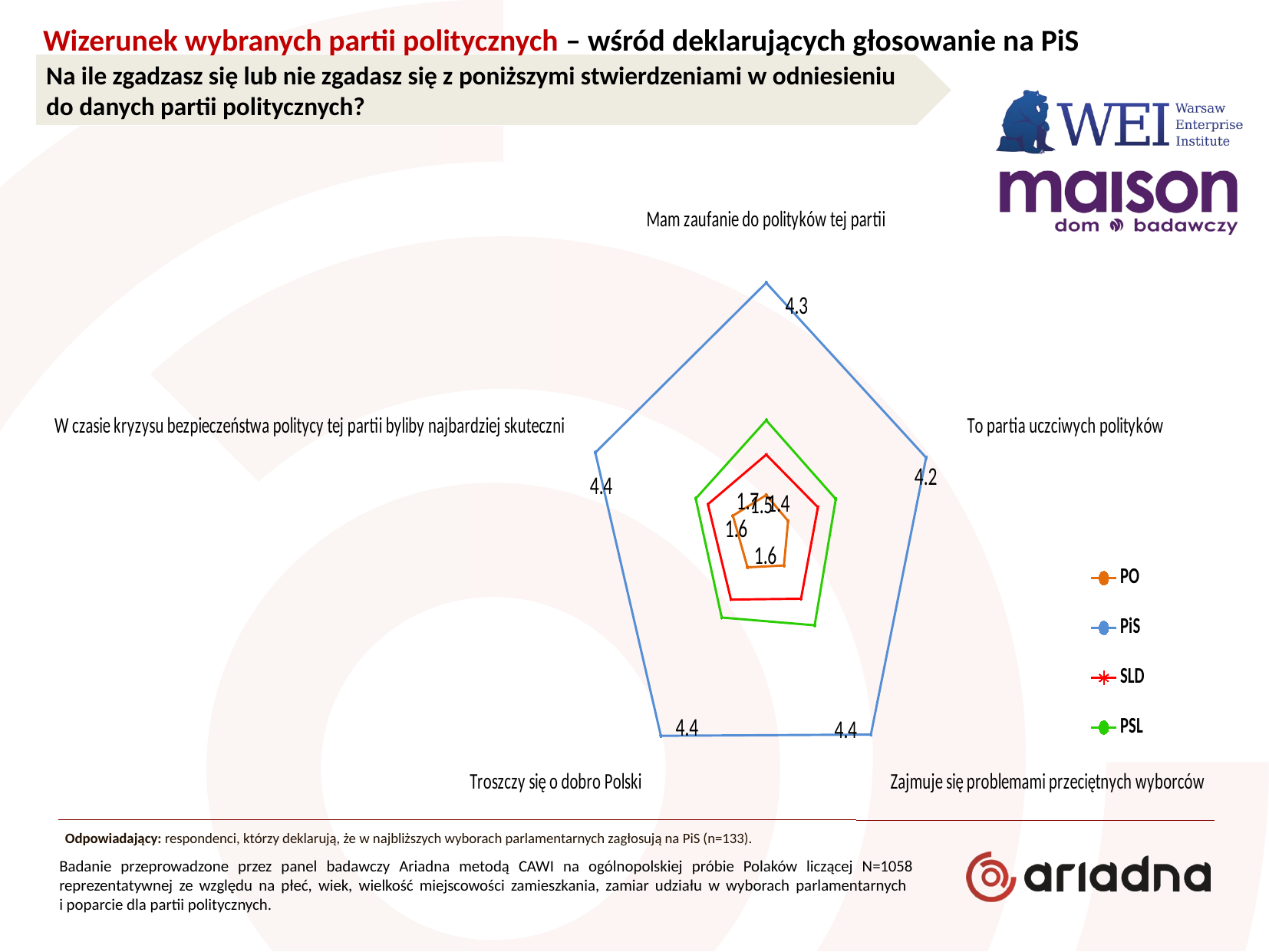
What is the PiS value for 'Mam zaufanie do polityków tej partii'? 4.3 How many statements (axes) does the radar chart have? 5 What is the PiS value for 'W czasie kryzysu bezpieczeństwa politycy tej partii byliby najbardziej skuteczni'? 4.4 What is the difference between the PiS values for 'Troszczy się o dobro Polski' and 'To partia uczciwych polityków'? 0.2 How many series does the legend list? 4 Which party has the largest values across all statements in the chart? PiS What is the PiS value for 'Troszczy się o dobro Polski'? 4.4 What is the PiS value for 'To partia uczciwych polityków'? 4.2 What kind of chart is shown on the slide? radar chart What is the PiS value for 'Zajmuje się problemami przeciętnych wyborców'? 4.4 For which statement does PiS have its lowest value? To partia uczciwych polityków Which parties are listed in the legend? PO, PiS, SLD, PSL